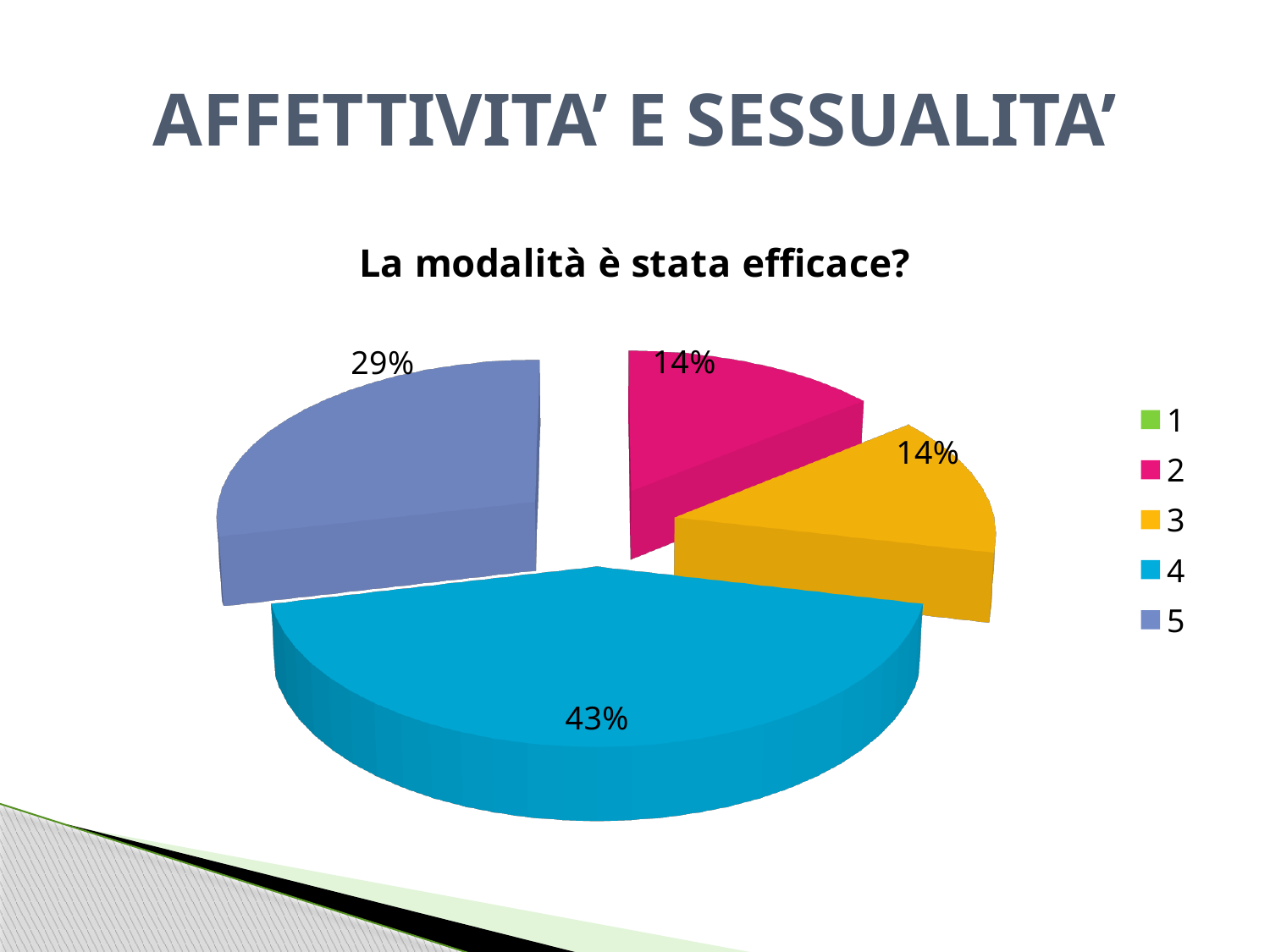
What share of the pie does category 2 have? 14% How many entries does the chart's legend list? 5 What share of the pie does category 3 have? 14% What is the title of the chart? La modalità è stata efficace? What is the difference in percentage points between the slices for category 4 and category 5? 14 Which is larger, the slice for category 5 or the slice for category 2? 5 How many slices with a visible percentage label are shown in the pie? 4 What colour is the slice for category 4? blue What type of chart is shown on the slide? pie chart Which category has the largest slice of the pie? 4 What share of the pie does category 5 have? 29%